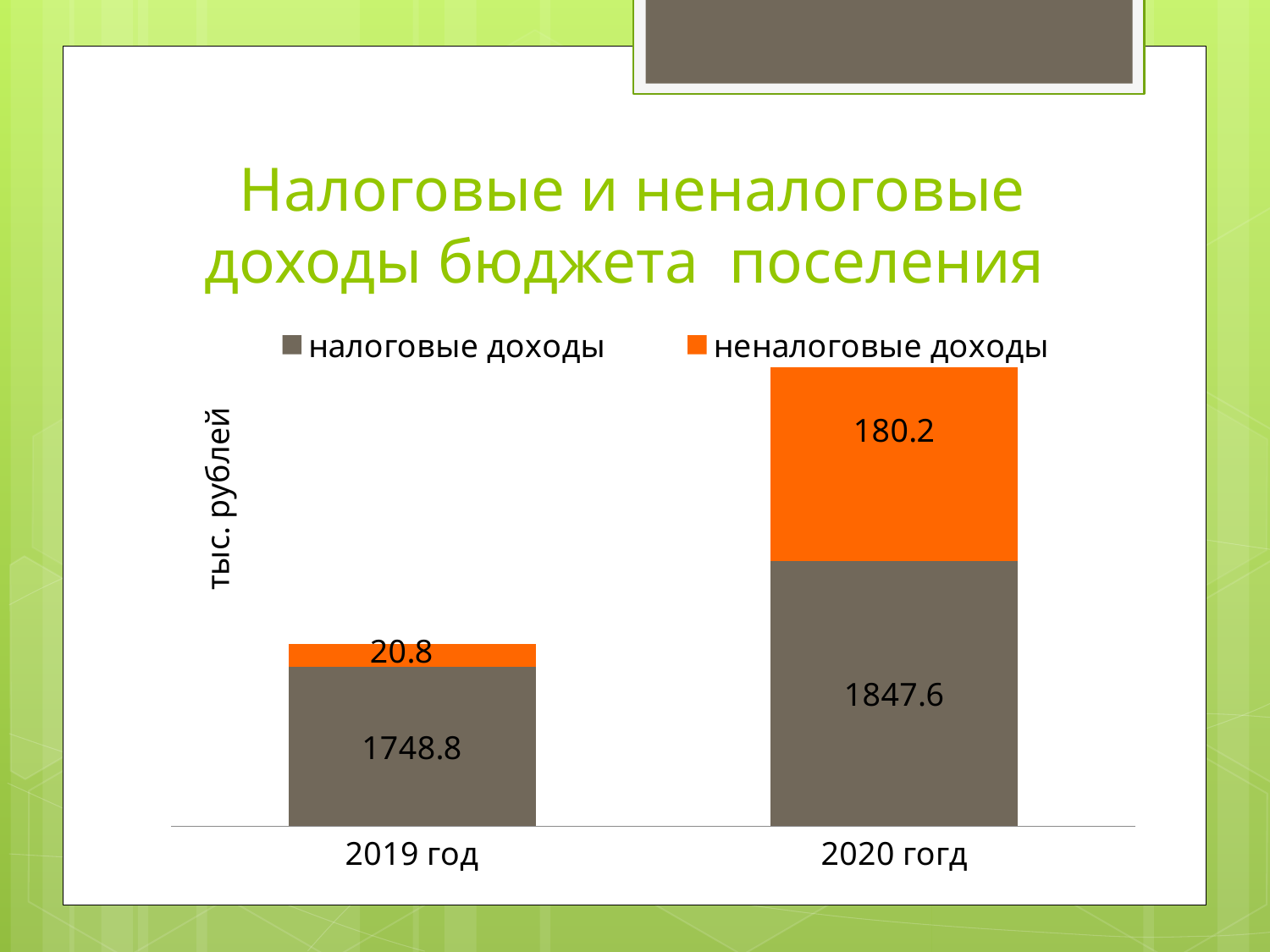
What is the difference in неналоговые доходы between 2020 гогд and 2019 год? 159.4 Which year has the higher value of неналоговые доходы? 2020 гогд What is the value of налоговые доходы for 2019 год? 1748.8 What is the value of неналоговые доходы for 2019 год? 20.8 By how much did налоговые доходы increase from 2019 год to 2020 гогд? 98.8 What is the total of the stacked bar for 2020 гогд? 2027.8 Which year has the lower value of налоговые доходы? 2019 год How many series does the legend list? 2 What is the value of налоговые доходы for 2020 гогд? 1847.6 What is the value of неналоговые доходы for 2020 гогд? 180.2 What is the total of the stacked bar for 2019 год? 1769.6 What kind of chart is shown on the slide? Stacked bar chart